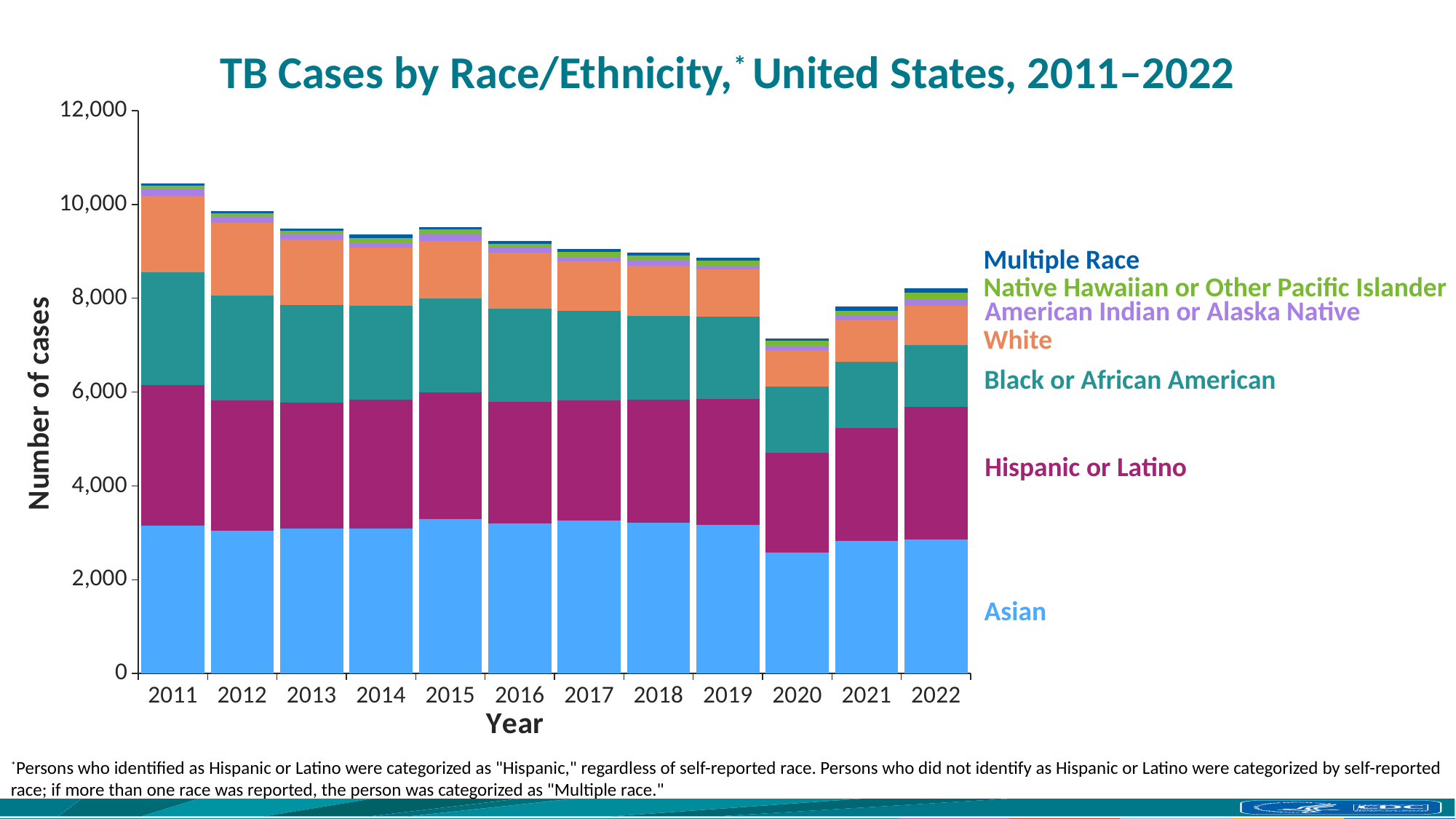
Is the total number of TB cases in 2020 greater or less than 8,000? less Which year has a larger total number of TB cases, 2019 or 2020? 2019 Is the number of Asian TB cases in 2020 greater or less than 3,000? less Do total TB cases generally rise or fall from 2011 to 2020? fall Is the total number of TB cases in 2011 greater or less than 10,000? greater How many years are shown along the x axis? 12 Which year has the highest total number of TB cases? 2011 What kind of chart is shown on the slide? Stacked bar chart Which year has the lowest total number of TB cases? 2020 How many race/ethnicity series does the legend list? 7 Which race/ethnicity series forms the bottom segment of each stacked bar? Asian What is the title of the chart? TB Cases by Race/Ethnicity, United States, 2011–2022